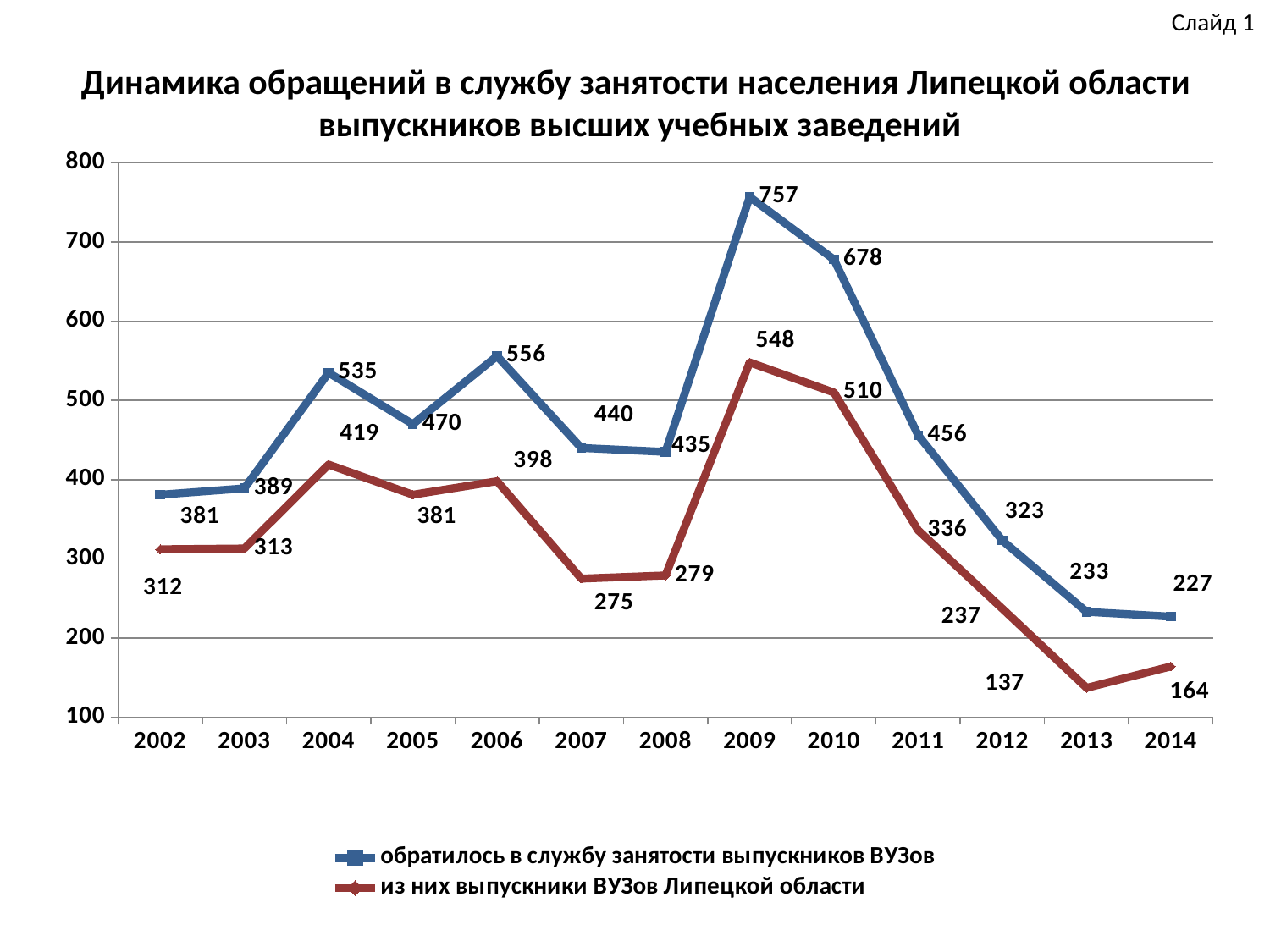
In which year is the series 'из них выпускники ВУЗов Липецкой области' at its lowest? 2013 What is the difference between the two series in 2010? 168 Which is larger: the value for 2004 or the value for 2006 in the series 'обратилось в службу занятости выпускников ВУЗов'? 2006 In which year is the series 'обратилось в службу занятости выпускников ВУЗов' at its highest? 2009 Is the value for 2012 in the series 'из них выпускники ВУЗов Липецкой области' greater or less than 300? less What is the value for 2013 in the series 'из них выпускники ВУЗов Липецкой области'? 137 Do the values of the series 'обратилось в службу занятости выпускников ВУЗов' rise or fall from 2009 to 2014? fall What is the value for 2009 in the series 'обратилось в службу занятости выпускников ВУЗов'? 757 What colour is the line for the series 'из них выпускники ВУЗов Липецкой области'? red What type of chart is shown on the slide? line chart How many years are plotted along the x axis? 13 How many series does the legend list? 2